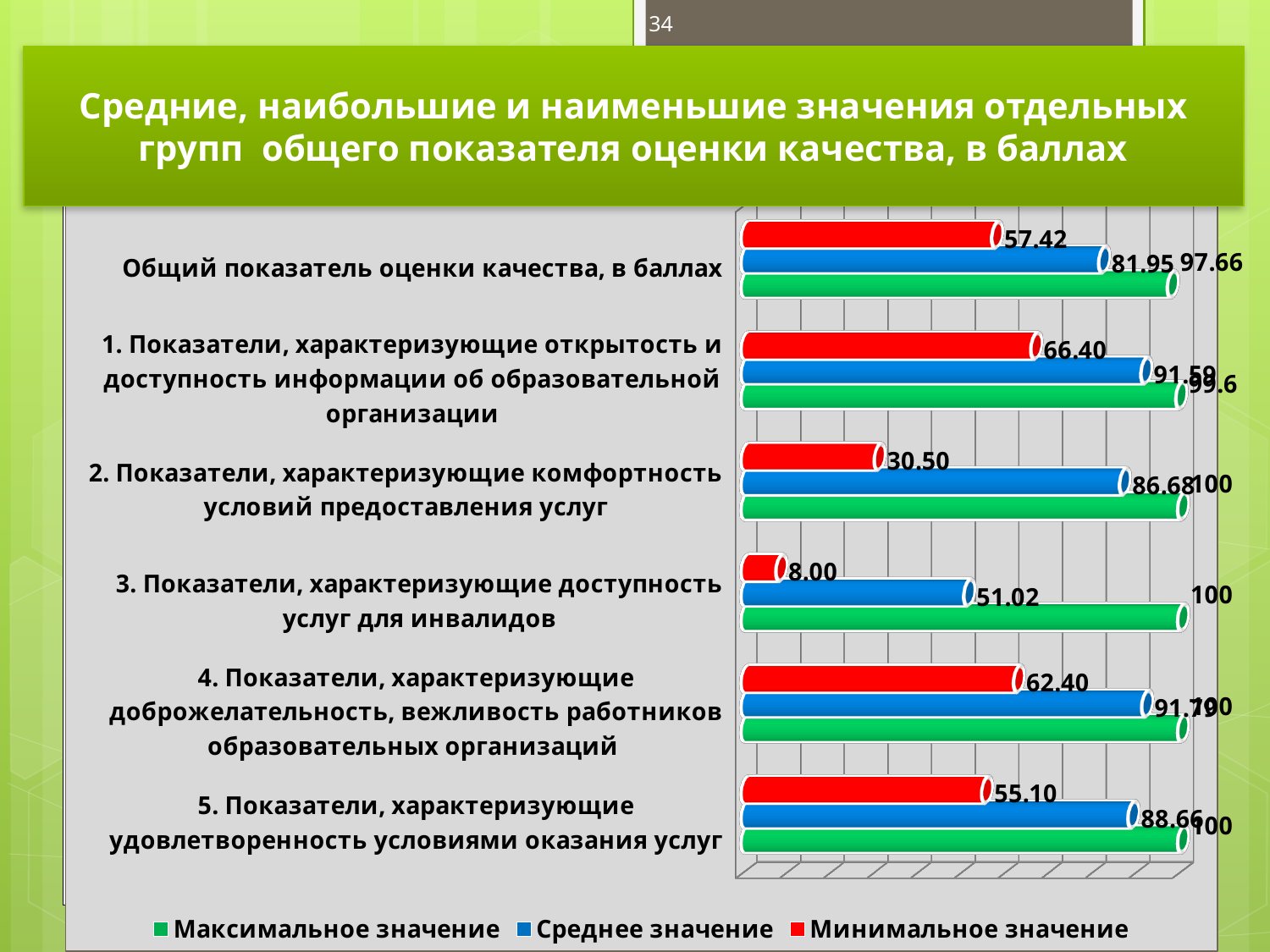
How many categories are shown on the chart? 6 Which category has the lowest minimum value? 3. Показатели, характеризующие доступность услуг для инвалидов What is the minimum value (Минимальное значение) for category 3 (Показатели, характеризующие доступность услуг для инвалидов)? 8.00 How many series does the legend list? 3 What is the minimum value for category 2 (Показатели, характеризующие комфортность условий предоставления услуг)? 30.50 What is the maximum value (Максимальное значение) for Общий показатель оценки качества, в баллах? 97.66 What is the difference between the maximum and minimum values for category 3 (доступность услуг для инвалидов)? 92 What kind of chart is shown on the slide? Bar chart What is the average value for category 3 (Показатели, характеризующие доступность услуг для инвалидов)? 51.02 Which category has the lowest average value (Среднее значение)? 3. Показатели, характеризующие доступность услуг для инвалидов Which has the larger average value: category 2 (комфортность условий предоставления услуг) or category 5 (удовлетворенность условиями оказания услуг)? 5. Показатели, характеризующие удовлетворенность условиями оказания услуг What is the average value (Среднее значение) for Общий показатель оценки качества, в баллах? 81.95